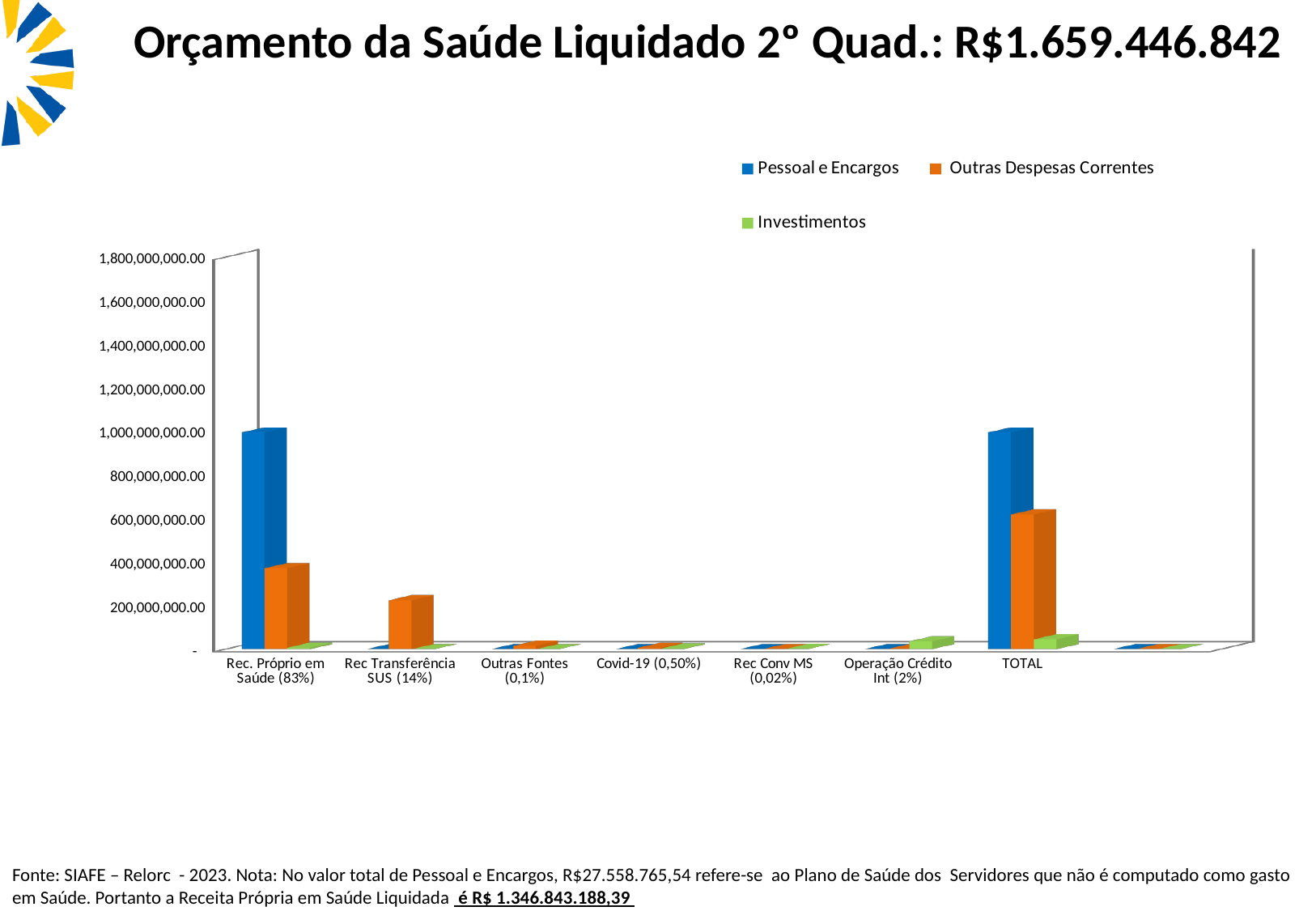
For Rec Transferência SUS (14%), which series has the highest value? Outras Despesas Correntes Is the Outras Despesas Correntes value for TOTAL greater or less than 400,000,000.00? greater Which is larger: the Outras Despesas Correntes value for Rec. Próprio em Saúde (83%) or for Rec Transferência SUS (14%)? Rec. Próprio em Saúde (83%) How many series does the chart legend list? 3 Which series is shown in green in the chart legend? Investimentos For the TOTAL category, which series has the highest value? Pessoal e Encargos Is the Pessoal e Encargos value for Rec. Próprio em Saúde (83%) greater or less than 800,000,000.00? greater Is the Outras Despesas Correntes value for Rec. Próprio em Saúde (83%) greater or less than 600,000,000.00? less What is the title of the chart on the slide? Orçamento da Saúde Liquidado 2° Quad.: R$1.659.446.842 What kind of chart is shown on the slide? bar chart